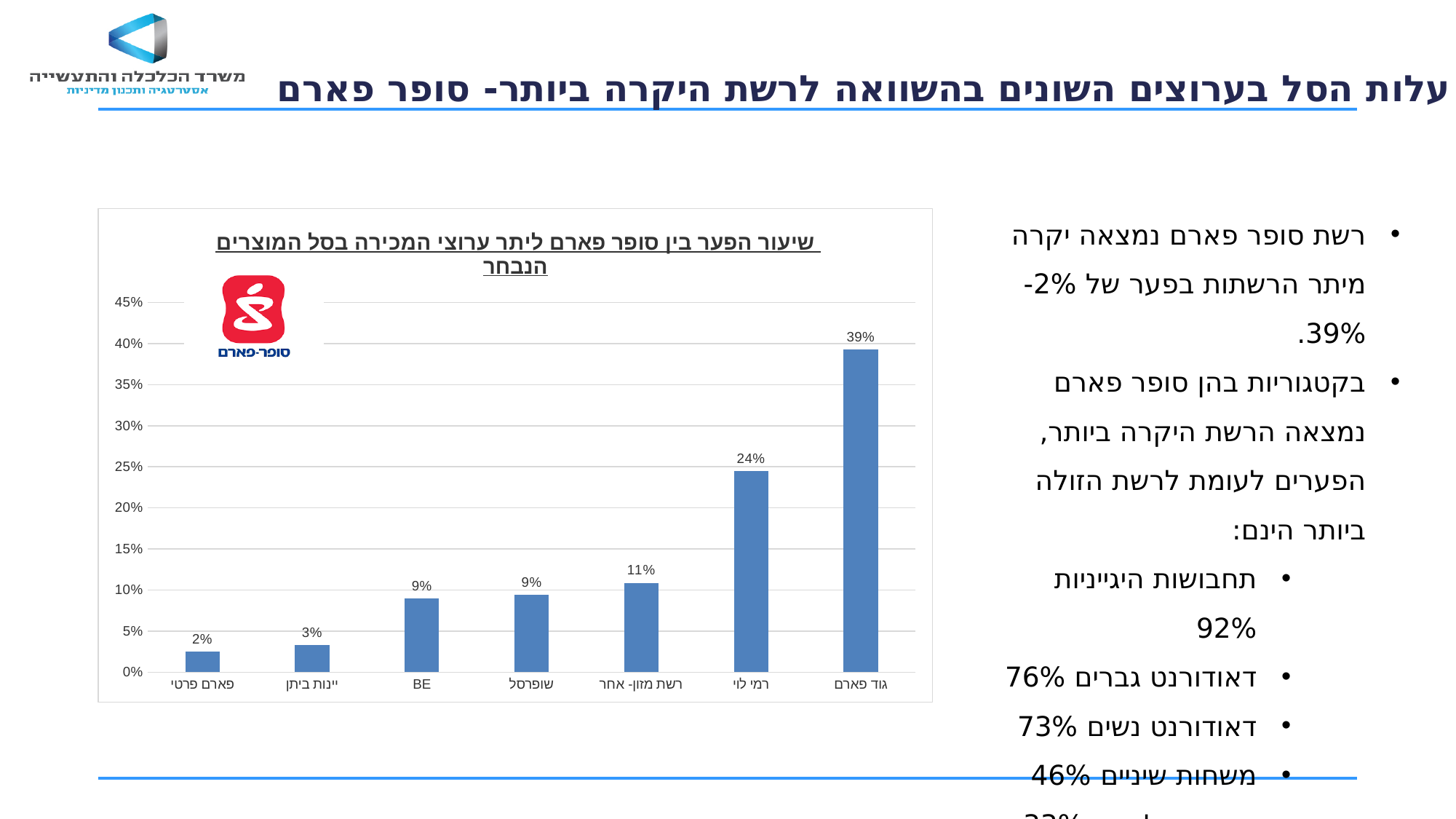
What is the value for רשת מזון- אחר? 11% Is the value for רמי לוי greater or less than 20%? greater Which category has the highest value? גוד פארם Which is larger, the value for שופרסל or the value for רמי לוי? רמי לוי What is the value for גוד פארם? 39% How many categories are shown in the chart? 7 What is the title of the chart? שיעור הפער בין סופר פארם ליתר ערוצי המכירה בסל המוצרים הנבחר What is the difference between the values for גוד פארם and רמי לוי? 15% What kind of chart is shown on the slide? Bar chart Which category has the lowest value? פארם פרטי What is the value for יינות ביתן? 3% What is the value for רמי לוי? 24%